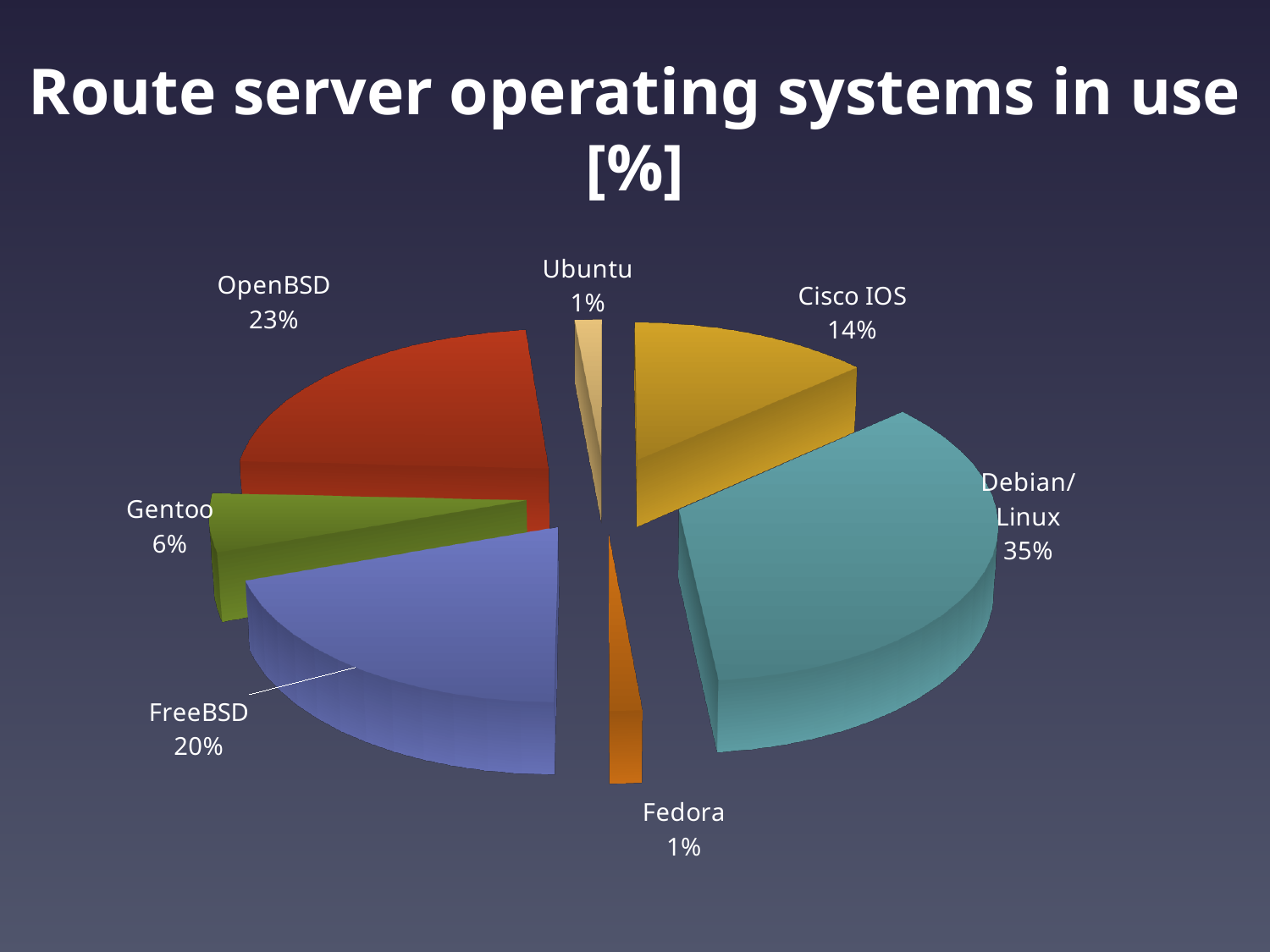
What share of the pie does Debian/Linux have? 35% What share of the pie does Cisco IOS have? 14% How many operating systems are shown as slices in the pie chart? 7 What is the difference in percentage points between Debian/Linux and OpenBSD? 12 What share of the pie does Gentoo have? 6% What is the title of the chart? Route server operating systems in use [%] Which has a larger share, FreeBSD or Cisco IOS? FreeBSD Which operating system has the largest share of the pie? Debian/Linux What colour is the Debian/Linux slice? Teal What kind of chart is shown on the slide? Pie chart What share of the pie does FreeBSD have? 20% What share of the pie does OpenBSD have? 23%